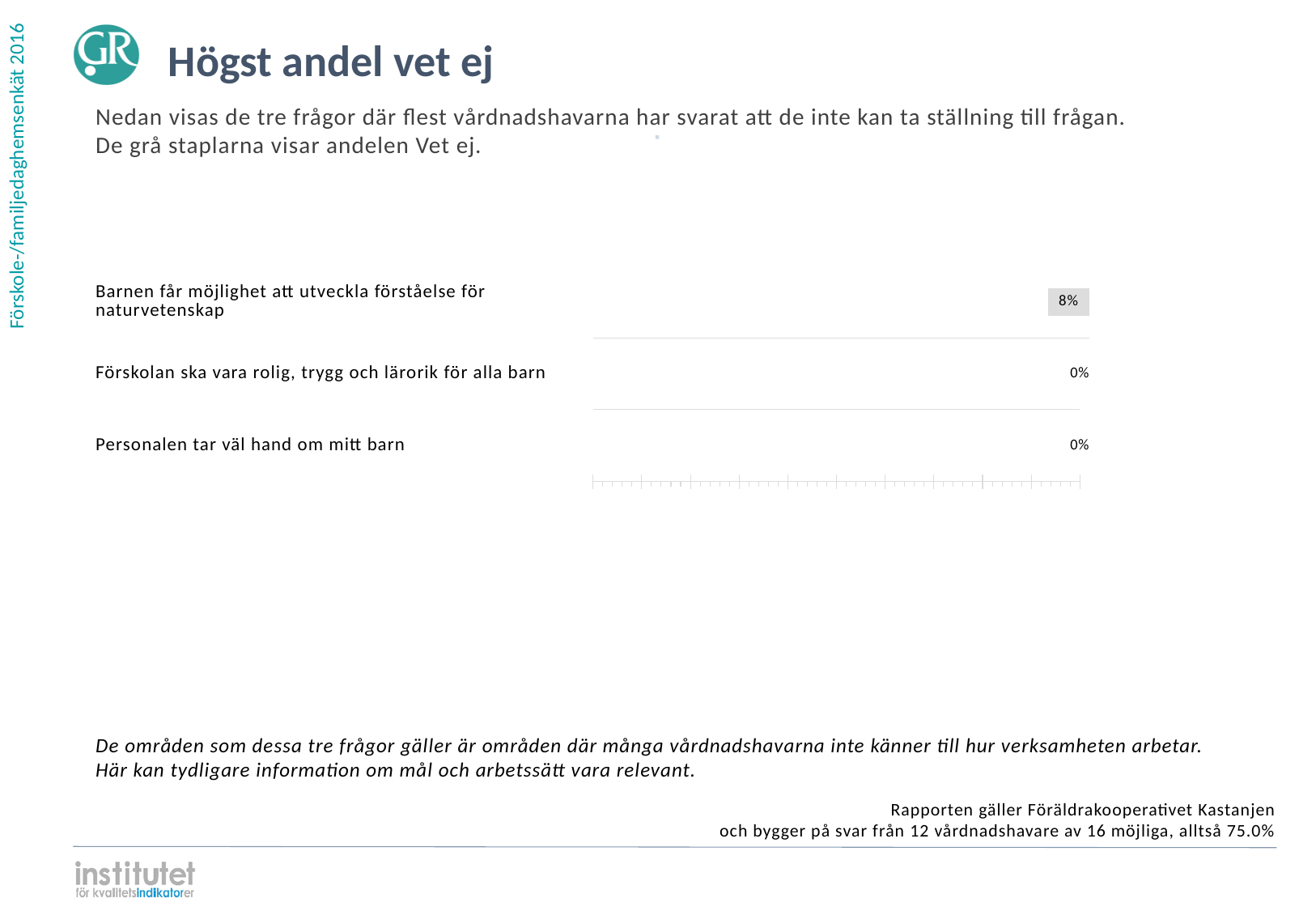
Which has a larger Vet ej share: "Barnen får möjlighet att utveckla förståelse för naturvetenskap" or "Förskolan ska vara rolig, trygg och lärorik för alla barn"? Barnen får möjlighet att utveckla förståelse för naturvetenskap What kind of chart is shown on the slide? Bar chart Which question has the highest Vet ej share? Barnen får möjlighet att utveckla förståelse för naturvetenskap What is the difference between the Vet ej share for "Barnen får möjlighet att utveckla förståelse för naturvetenskap" and for "Personalen tar väl hand om mitt barn"? 8% What is the Vet ej share for "Barnen får möjlighet att utveckla förståelse för naturvetenskap"? 8% What colour are the bars showing the Vet ej share? Grey What is the Vet ej share for "Förskolan ska vara rolig, trygg och lärorik för alla barn"? 0% How many of the questions shown have a Vet ej share of 0%? 2 How many questions are shown in the chart? 3 What is the Vet ej share for "Personalen tar väl hand om mitt barn"? 0% What is the title of the slide containing the chart? Högst andel vet ej